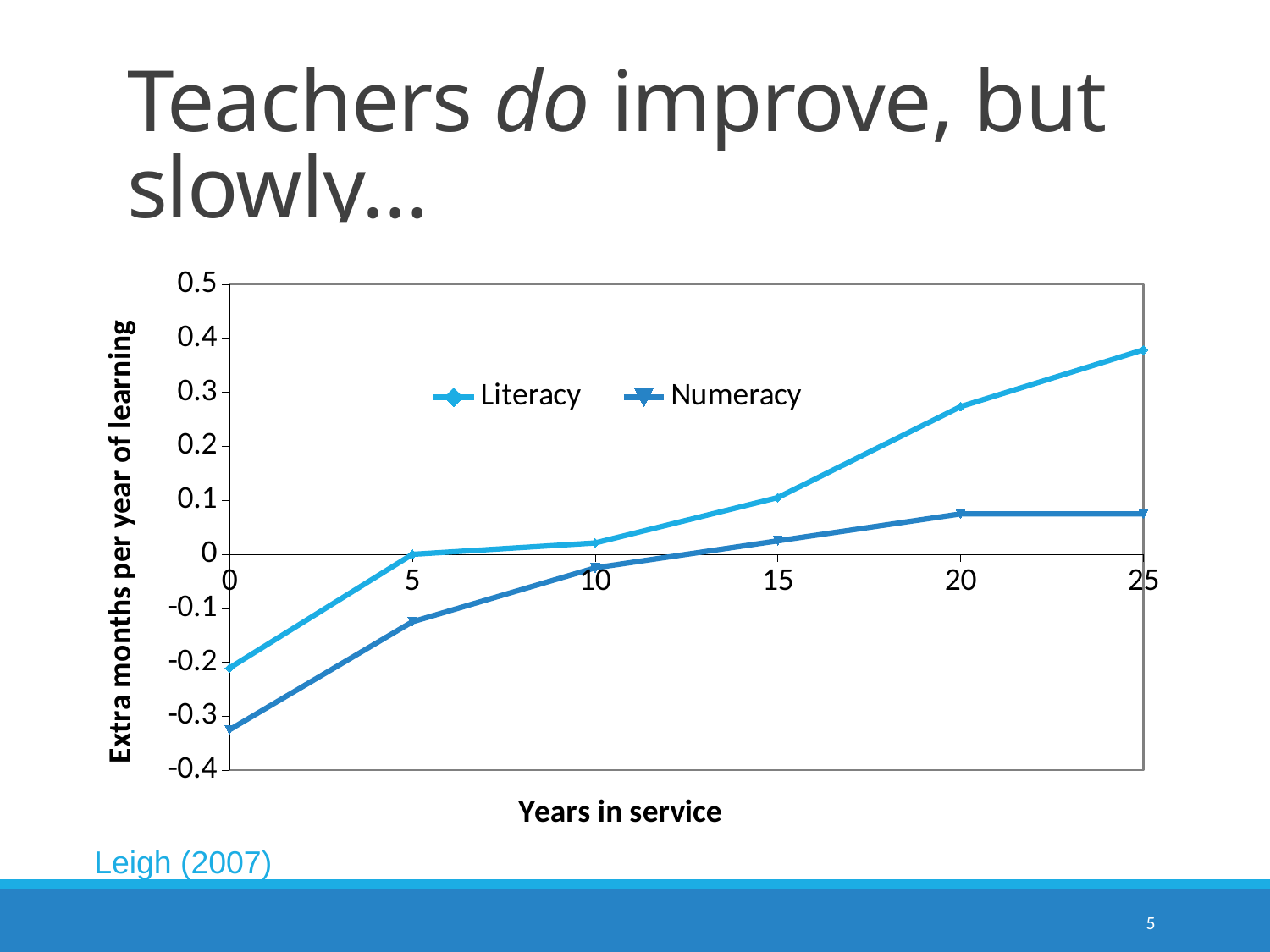
Does the Literacy series rise or fall as years in service increase? Rise How many series does the chart's legend list? 2 How many data points are plotted for the Literacy series? 6 What kind of chart is shown on the slide? Line chart Is the Numeracy value at 25 years in service greater or less than 0.1? less At which years-in-service value does the Literacy series reach its highest point? 25 Which series has the lowest value on the chart, and at which years in service? Numeracy at 0 At 25 years in service, which series has the higher value, Literacy or Numeracy? Literacy Is the Literacy value at 25 years in service greater or less than 0.3? greater Is the Numeracy value at 0 years in service greater or less than -0.3? less What is the title of the chart's x axis? Years in service